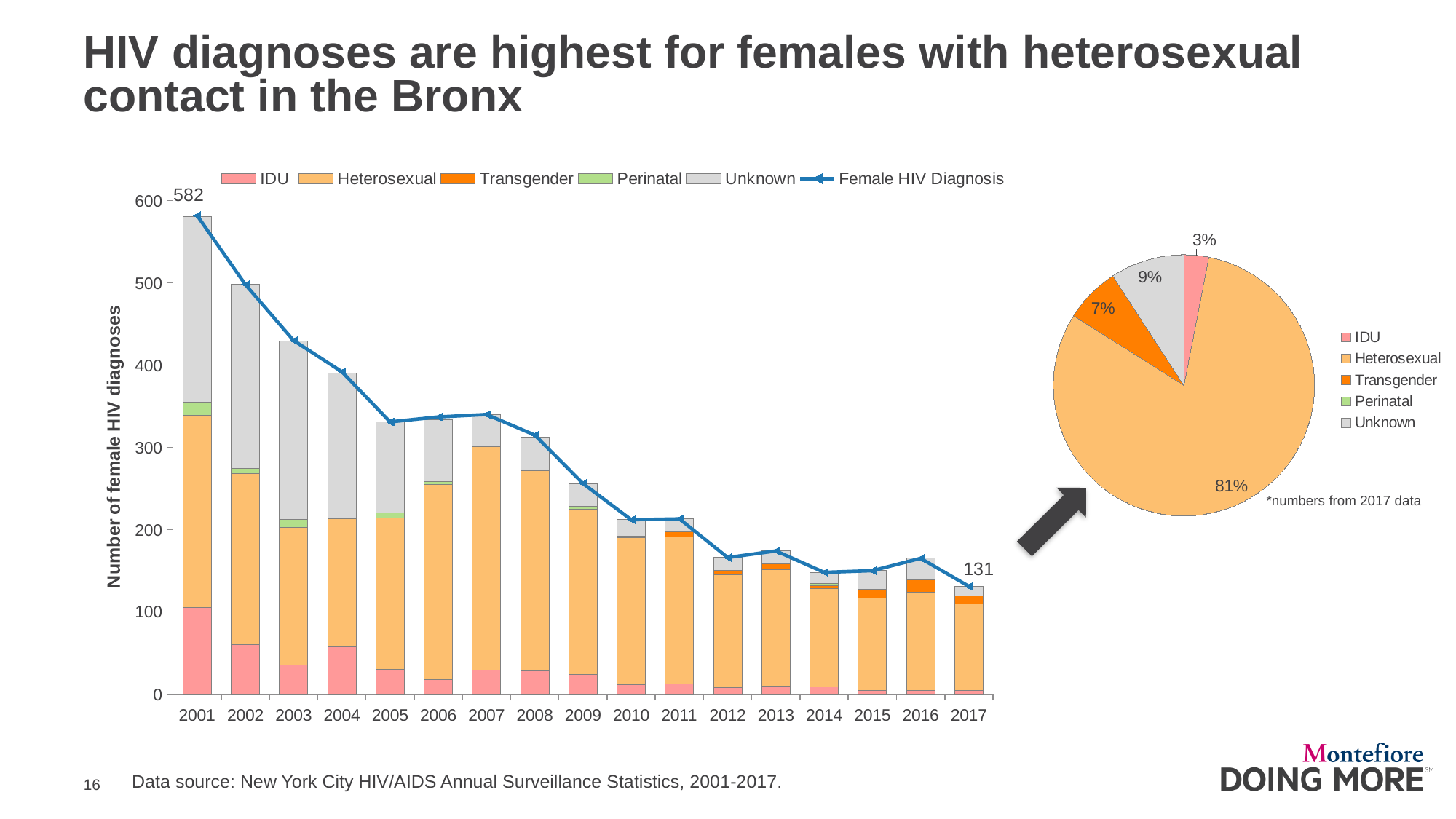
In the bar chart on the left, what is the value of the Female HIV Diagnosis line for 2001? 582 What kind of chart is the chart on the left of the slide? stacked bar chart with a line In the bar chart on the left, what is the value of the Female HIV Diagnosis line for 2017? 131 In the pie chart on the right, which category has the largest slice? Heterosexual How many years are shown on the x axis of the bar chart on the left? 17 In the pie chart on the right, what share is Transgender? 7% How many entries does the legend of the bar chart on the left list? 6 In the pie chart on the right, what share is Heterosexual? 81% In the pie chart on the right, which is larger: Unknown or Transgender? Unknown In the bar chart on the left, is the total for 2012 greater or less than 200? less In the bar chart on the left, what is the difference between the Female HIV Diagnosis values for 2001 and 2017? 451 In the bar chart on the left, do the Female HIV Diagnosis values generally rise or fall from 2001 to 2017? fall